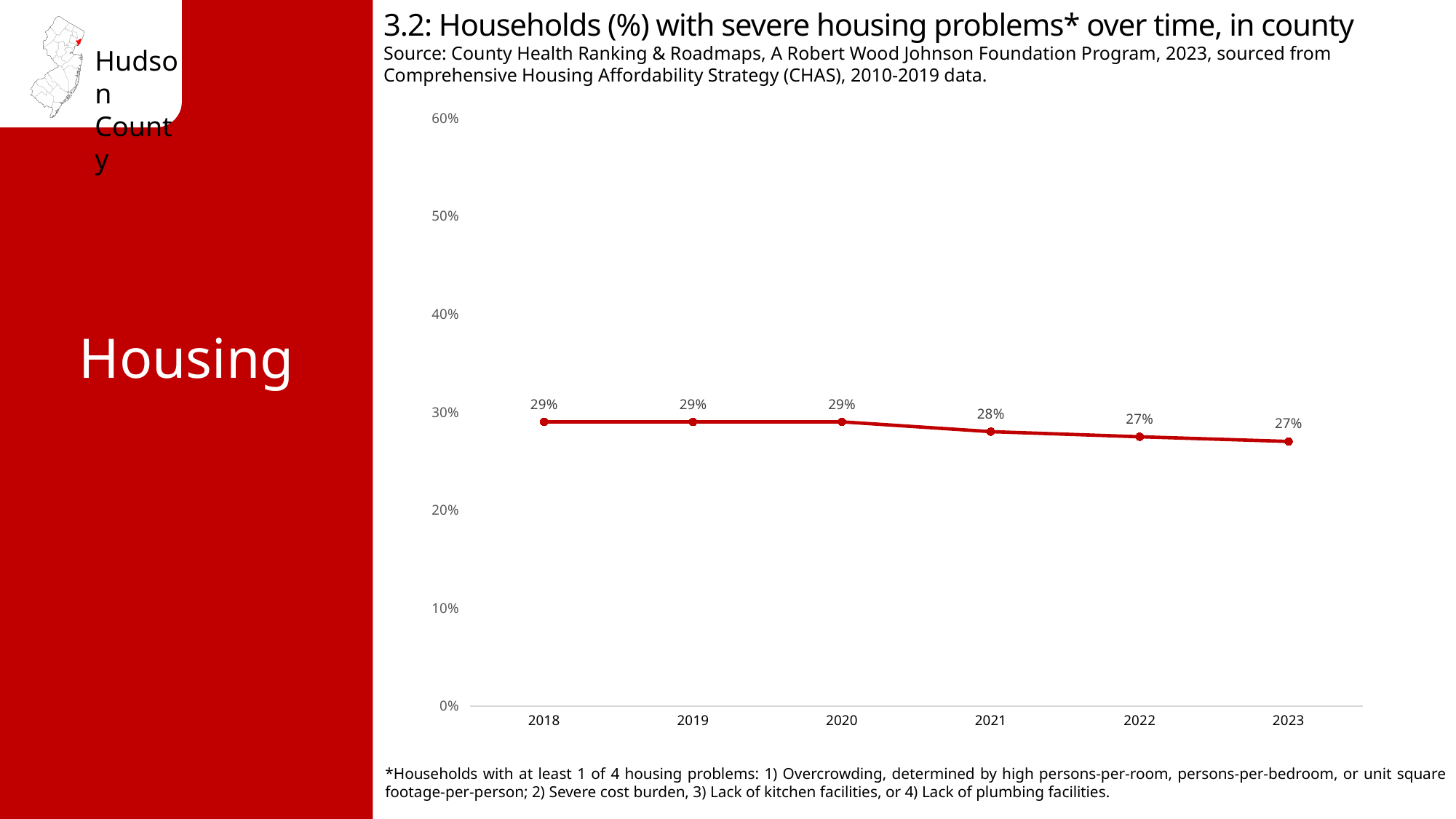
How many years are plotted on the chart? 6 Do the values rise or fall from 2018 to 2023? fall What is the value shown for 2021? 28% What is the value shown for 2020? 29% Is the value for 2020 larger or smaller than the value for 2022? larger What is the difference between the 2018 value and the 2023 value? 2 percentage points Is the value for 2019 greater or less than 40%? less What percentage of households had severe housing problems in 2023? 27% What kind of chart is shown on the slide? line chart What percentage of households had severe housing problems in 2018? 29% What is the title of the chart? 3.2: Households (%) with severe housing problems* over time, in county